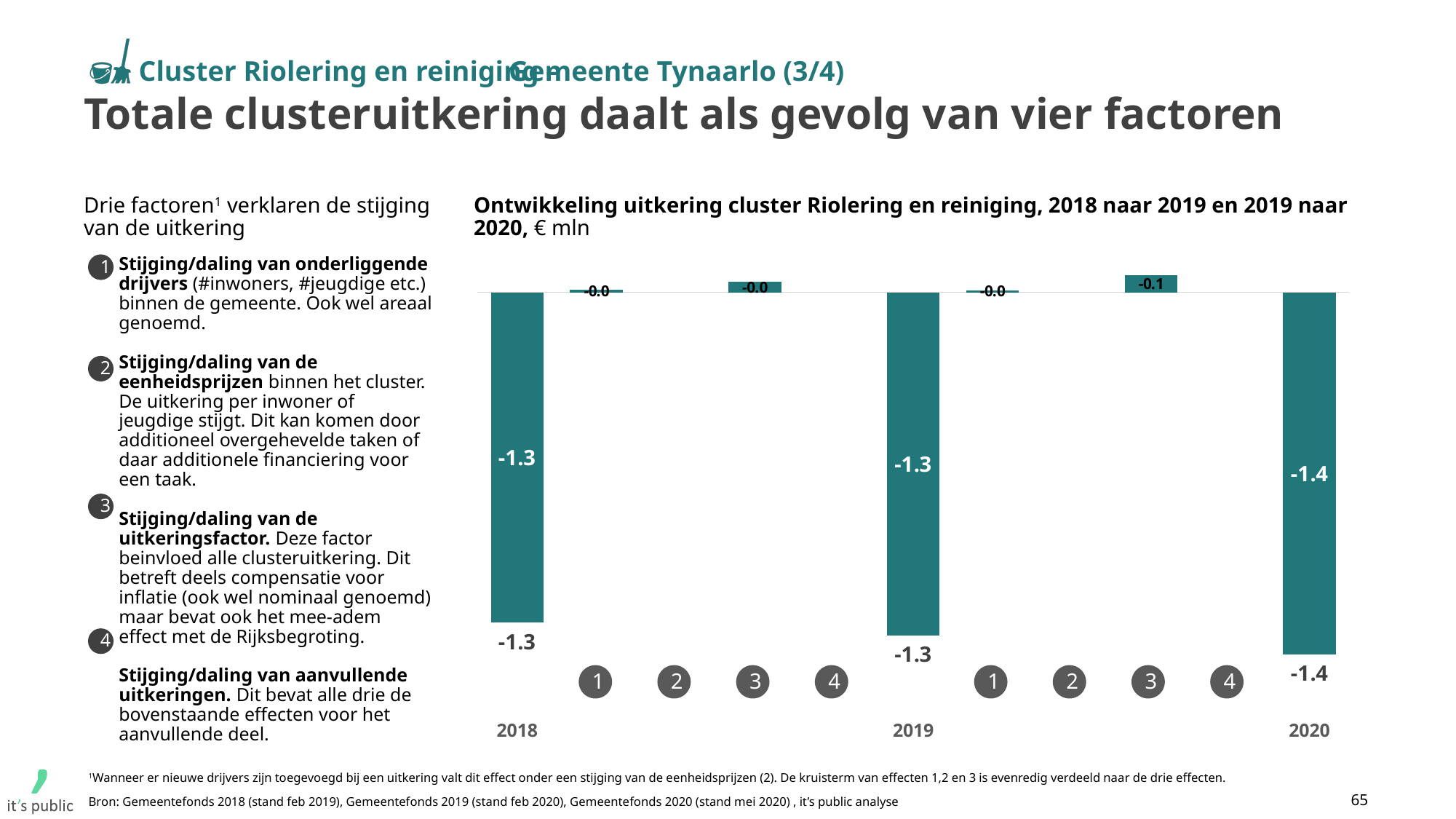
In what unit are the chart values expressed? € mln Which is more negative, the 2019 bar or the 2020 bar? 2020 What is the difference between the 2018 value and the 2020 value? 0.1 What is the value of the 2018 bar? -1.3 What is the value shown for factor 3 between 2019 and 2020? -0.1 How many year totals (2018, 2019, 2020) are shown as large bars in the chart? 3 What is the value of the 2019 bar? -1.3 Do the year totals rise or fall from 2018 to 2020? Fall What kind of chart is shown on the slide? Bar chart What is the value of the 2020 bar? -1.4 What is the value shown for factor 1 between 2018 and 2019? -0.0 Which year has the lowest (most negative) total value? 2020